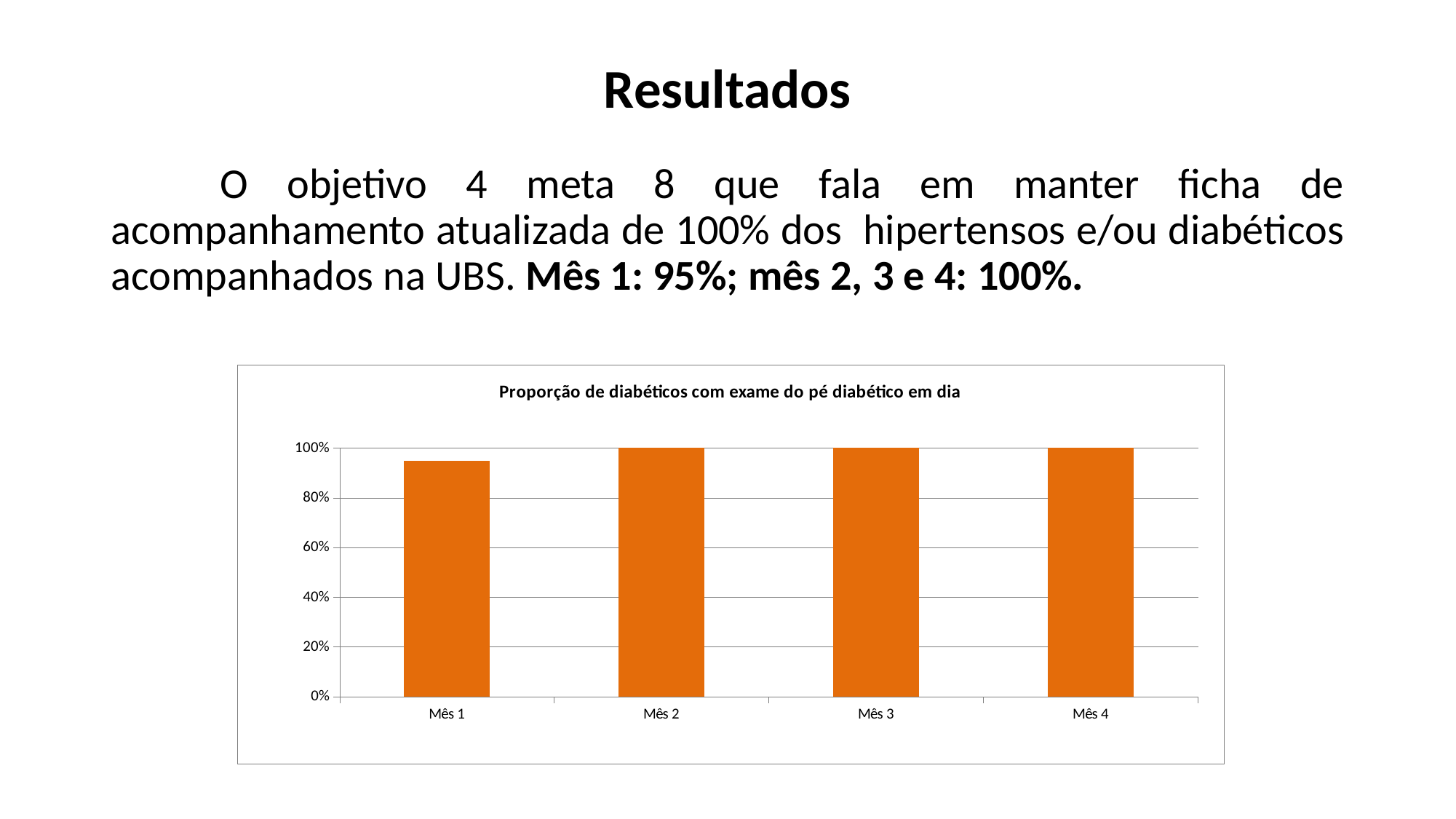
How many months (categories) are shown on the x axis of the chart? 4 What type of chart is shown on the slide? bar chart What is the value for Mês 1 in the chart? 95% Does the value rise or fall from Mês 1 to Mês 2? rise Is the value for Mês 1 greater or less than 80%? greater What is the value for Mês 2 in the chart? 100% Which is larger, the value for Mês 1 or the value for Mês 3? Mês 3 What colour are the bars in the chart? orange Which month has the lowest value in the chart? Mês 1 What is the title of the chart? Proporção de diabéticos com exame do pé diabético em dia What is the value for Mês 4 in the chart? 100% What is the difference between the value for Mês 2 and the value for Mês 1? 5%